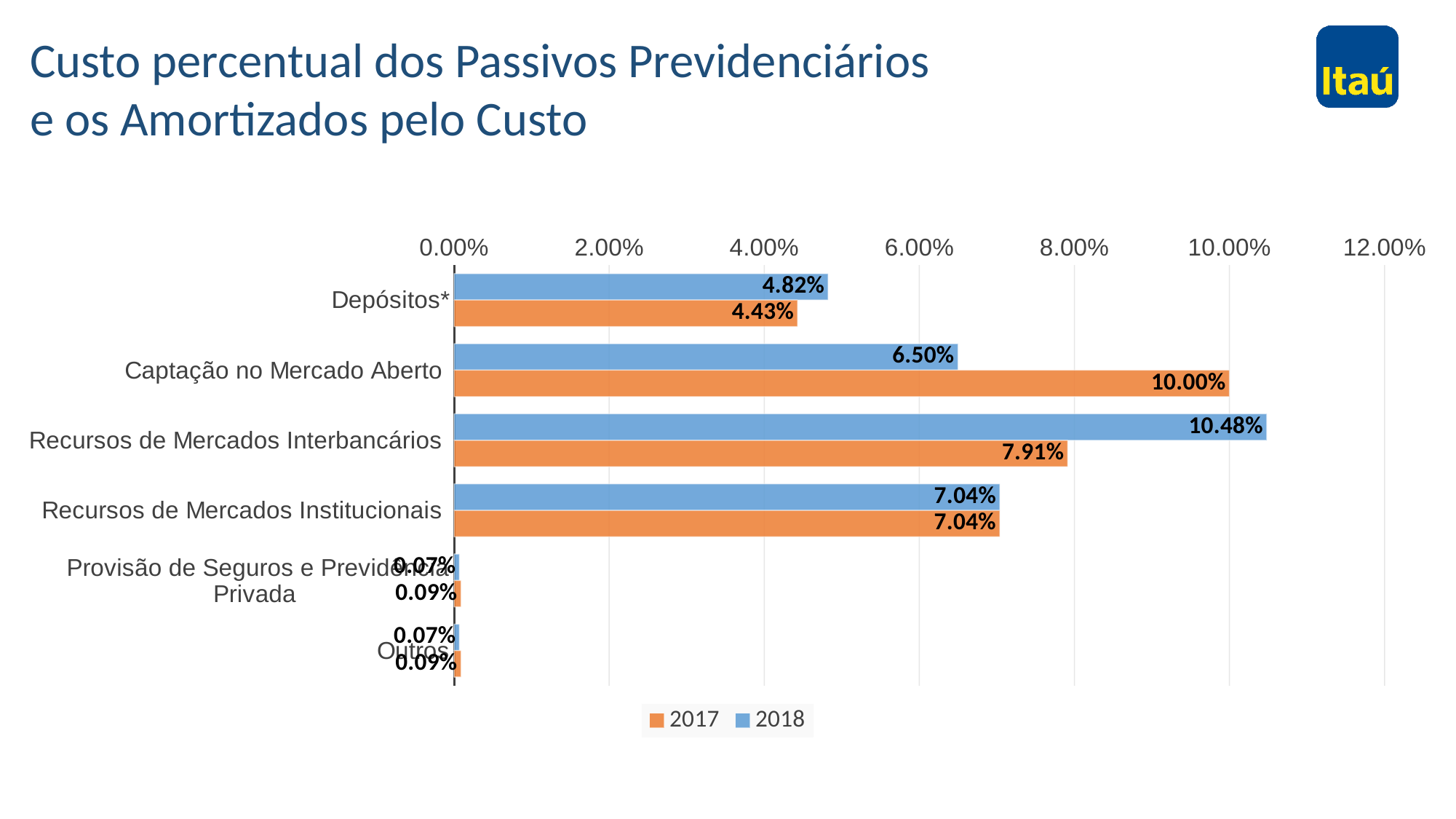
What is the 2017 value for Captação no Mercado Aberto? 10.00% How many series does the legend list? 2 What kind of chart is shown on the slide? Bar chart What is the 2018 value for Depósitos*? 4.82% What is the difference between the 2018 and 2017 values for Recursos de Mercados Interbancários? 2.57% Which category has the highest 2017 value? Captação no Mercado Aberto What is the difference between the 2017 and 2018 values for Captação no Mercado Aberto? 3.50% What is the 2017 value for Recursos de Mercados Institucionais? 7.04% What is the 2018 value for Recursos de Mercados Interbancários? 10.48% For Depósitos*, which year has the larger value, 2017 or 2018? 2018 How many categories are shown on the chart? 6 Which category has the highest 2018 value? Recursos de Mercados Interbancários